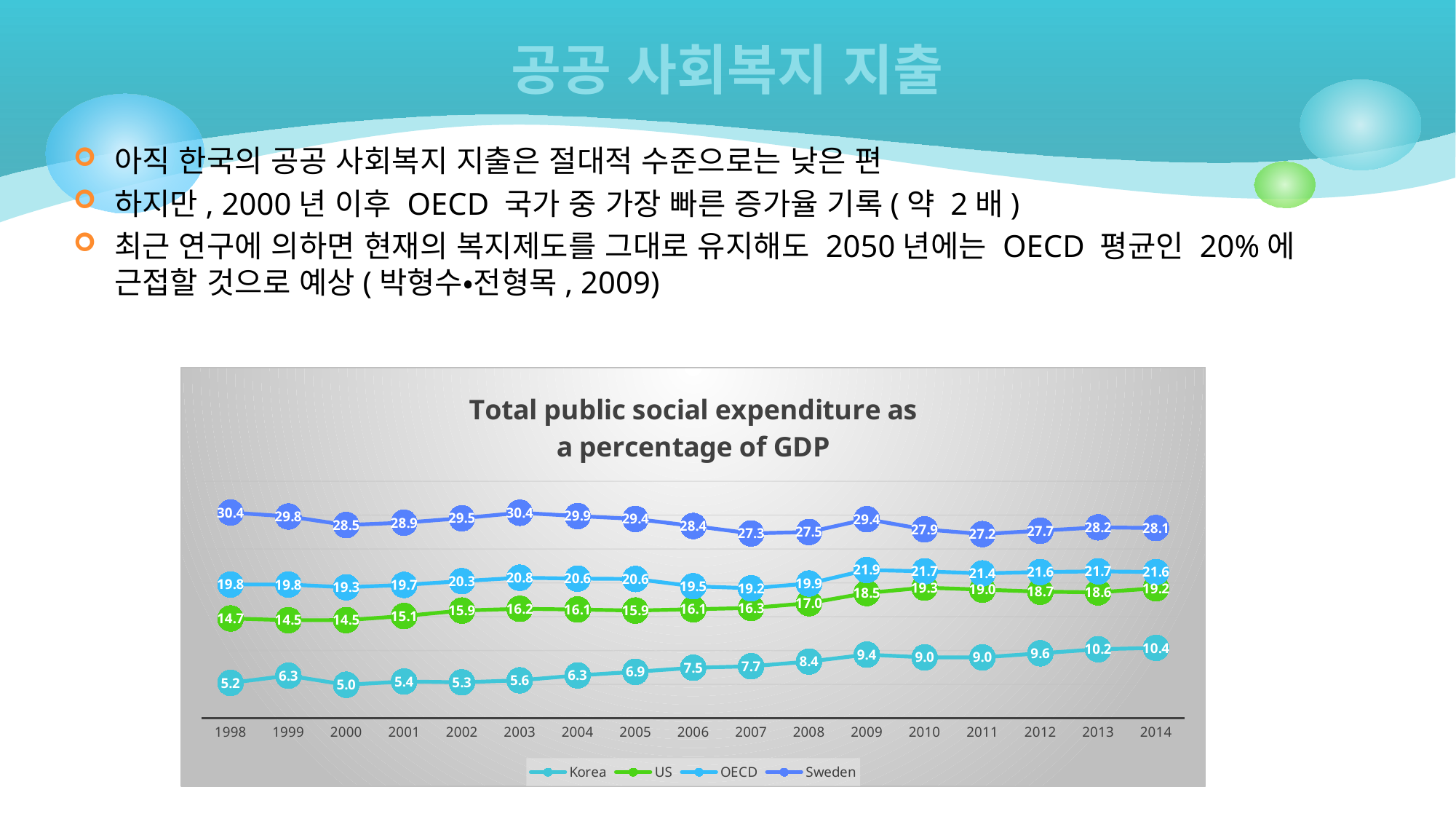
Which is larger in 2010, the OECD value or the US value? OECD In which year is the Korea value lowest? 2000 What is the title of the chart? Total public social expenditure as a percentage of GDP How many years are plotted along the x axis? 17 How many series does the legend list? 4 What type of chart is shown on the slide? line chart What is the value for Sweden in 2007? 27.3 Does the Korea series generally rise or fall from 1998 to 2014? rise What is the difference between the Sweden value and the Korea value in 1998? 25.2 What is the value for Korea in 2014? 10.4 What is the value for OECD in 2003? 20.8 What is the value for the US in 2009? 18.5